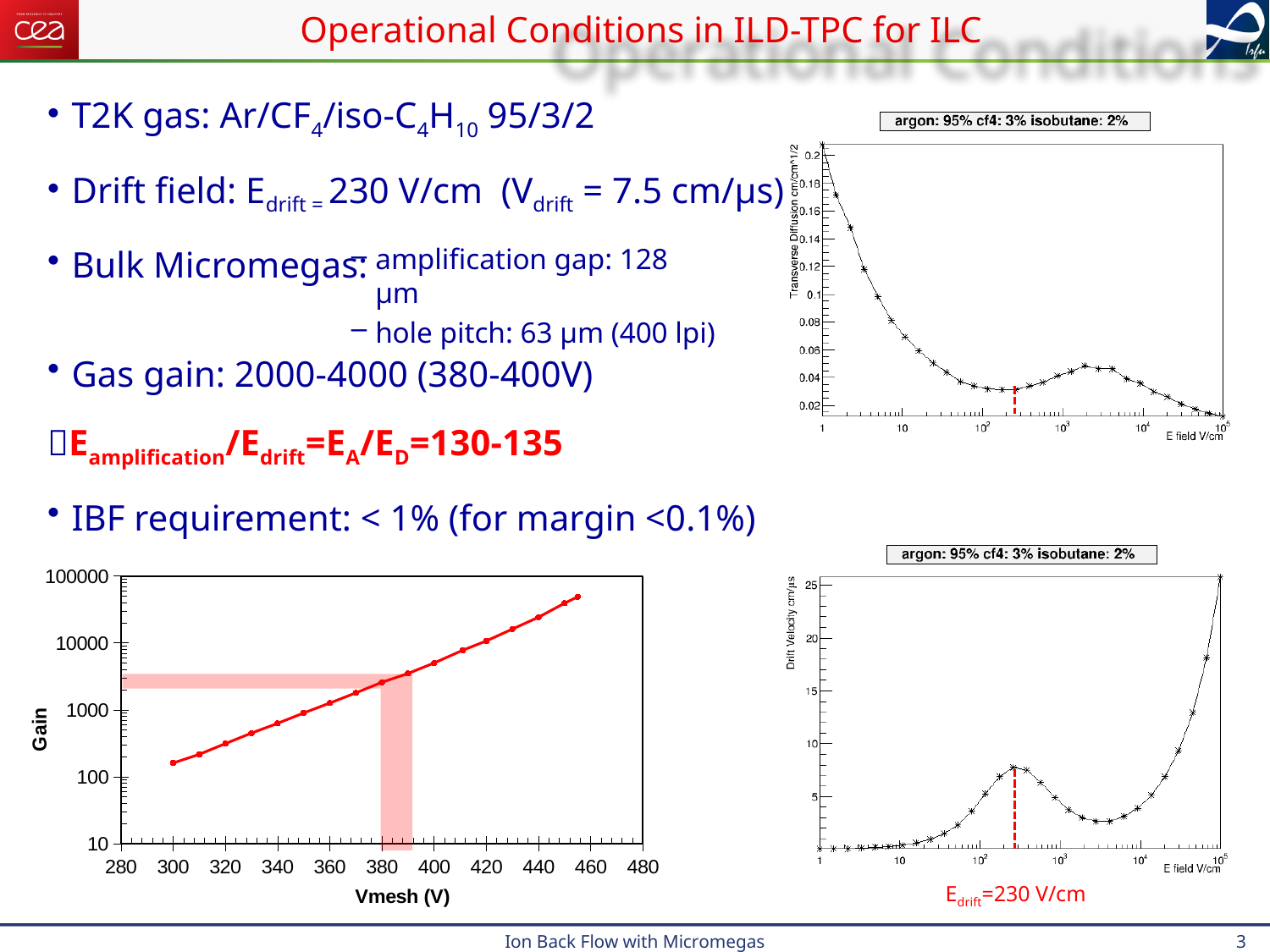
What is the x-axis label of the Gain chart at the bottom left? Vmesh (V) In the Gain vs Vmesh chart, is the gain at Vmesh = 300 V greater or less than 1000? less In the Transverse Diffusion chart at the top right, is the value at E field = 1 V/cm greater or less than 0.18? greater In the Gain vs Vmesh chart, does the gain rise or fall as Vmesh increases? rise What kind of chart is the Gain vs Vmesh chart at the bottom left of the slide? line chart In the Transverse Diffusion chart at the top right, does the diffusion rise or fall as the E field increases from 1 to 100 V/cm? fall In the Drift Velocity chart at the bottom right, is the drift velocity at E field = 10 V/cm greater or less than 5? less What gas mixture is given in the title of the Drift Velocity chart at the bottom right? argon: 95% cf4: 3% isobutane: 2%